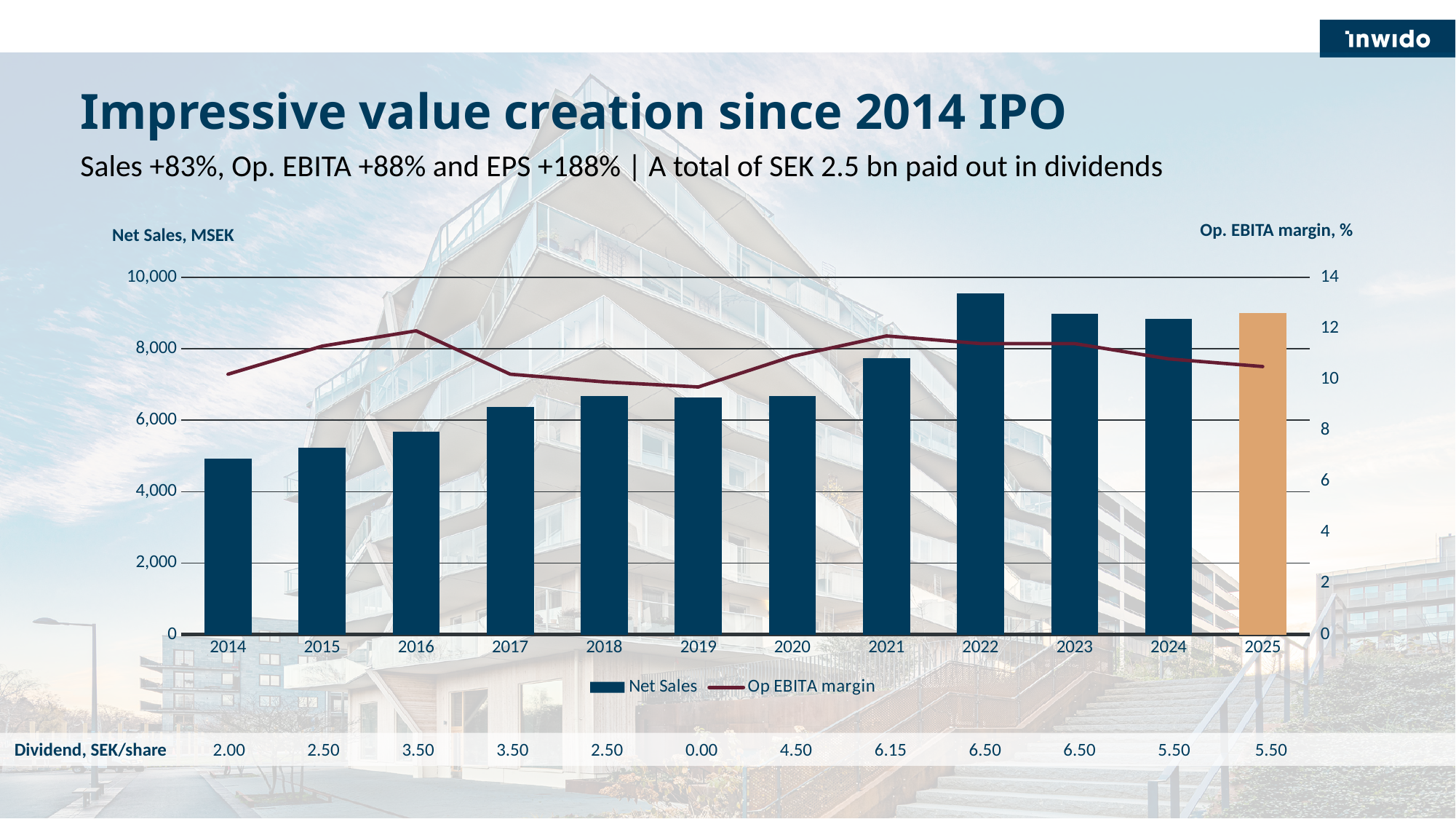
Is the Net Sales value for 2014 greater or less than 6,000 MSEK? less Which year has the highest Net Sales bar? 2022 What kind of chart is shown on the slide? A combined bar and line chart Which year has higher Net Sales, 2022 or 2023? 2022 What is the dividend per share shown for 2021? 6.15 Which bar is shown in a different colour (orange) from the others? 2025 Is the Op EBITA margin for 2016 greater or less than 10%? greater Do Net Sales rise or fall from 2014 to 2018? rise Which year has the lowest Net Sales bar? 2014 How many series does the legend list? 2 Is the Net Sales value for 2022 greater or less than 8,000 MSEK? greater How many years are shown on the x axis of the chart? 12